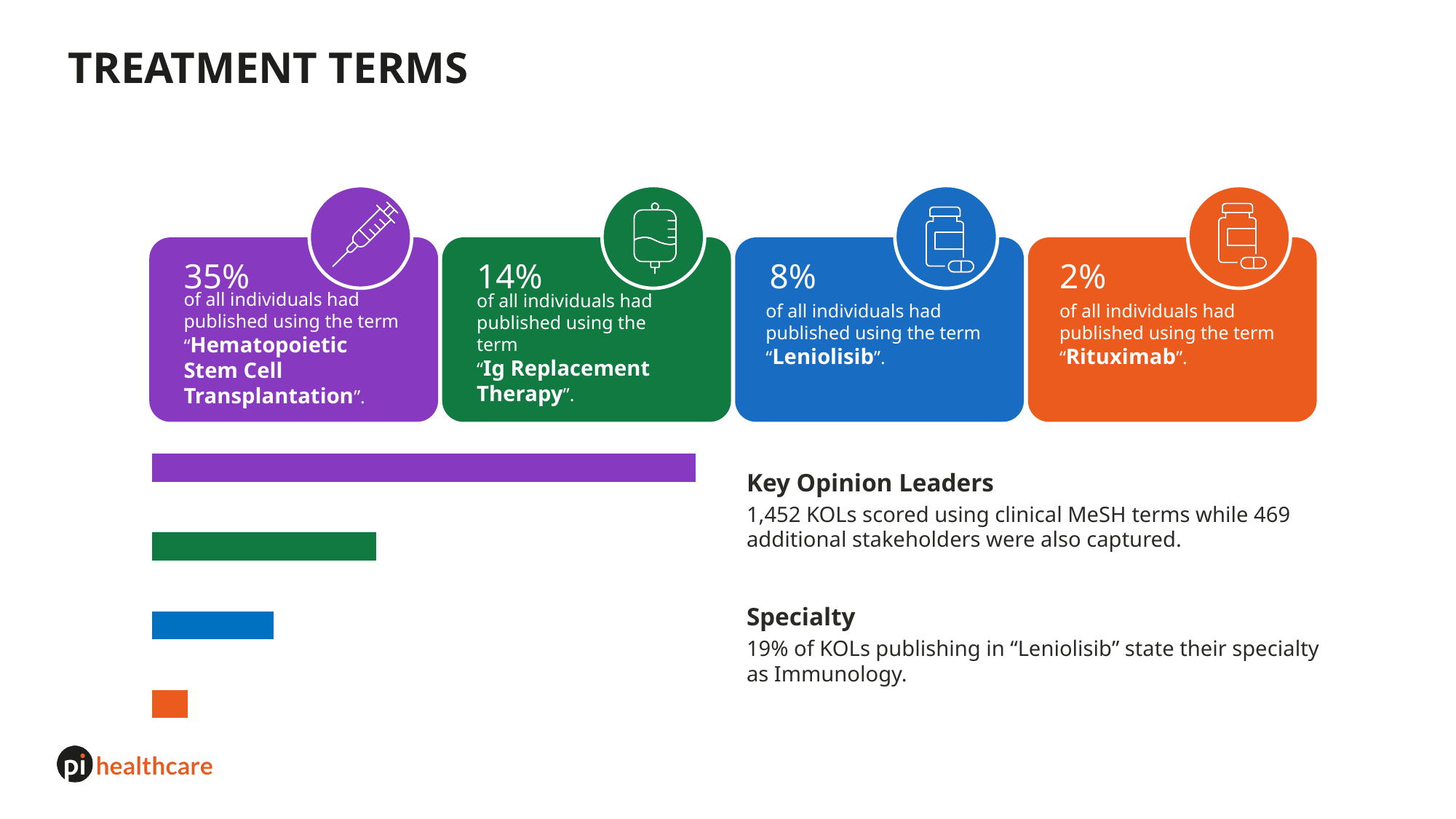
Which treatment term has the lowest percentage of individuals publishing with it? Rituximab Which has a larger percentage, "Leniolisib" or "Rituximab"? Leniolisib What percentage of all individuals had published using the term "Rituximab"? 2% Which treatment term has the highest percentage of individuals publishing with it? Hematopoietic Stem Cell Transplantation What colour is the bar representing "Leniolisib"? blue What kind of chart is shown on the slide? bar chart What percentage of all individuals had published using the term "Leniolisib"? 8% What percentage of all individuals had published using the term "Hematopoietic Stem Cell Transplantation"? 35% What is the title of the slide containing the chart? TREATMENT TERMS What is the difference in percentage points between "Hematopoietic Stem Cell Transplantation" and "Ig Replacement Therapy"? 21 What percentage of all individuals had published using the term "Ig Replacement Therapy"? 14% How many bars does the chart contain? 4